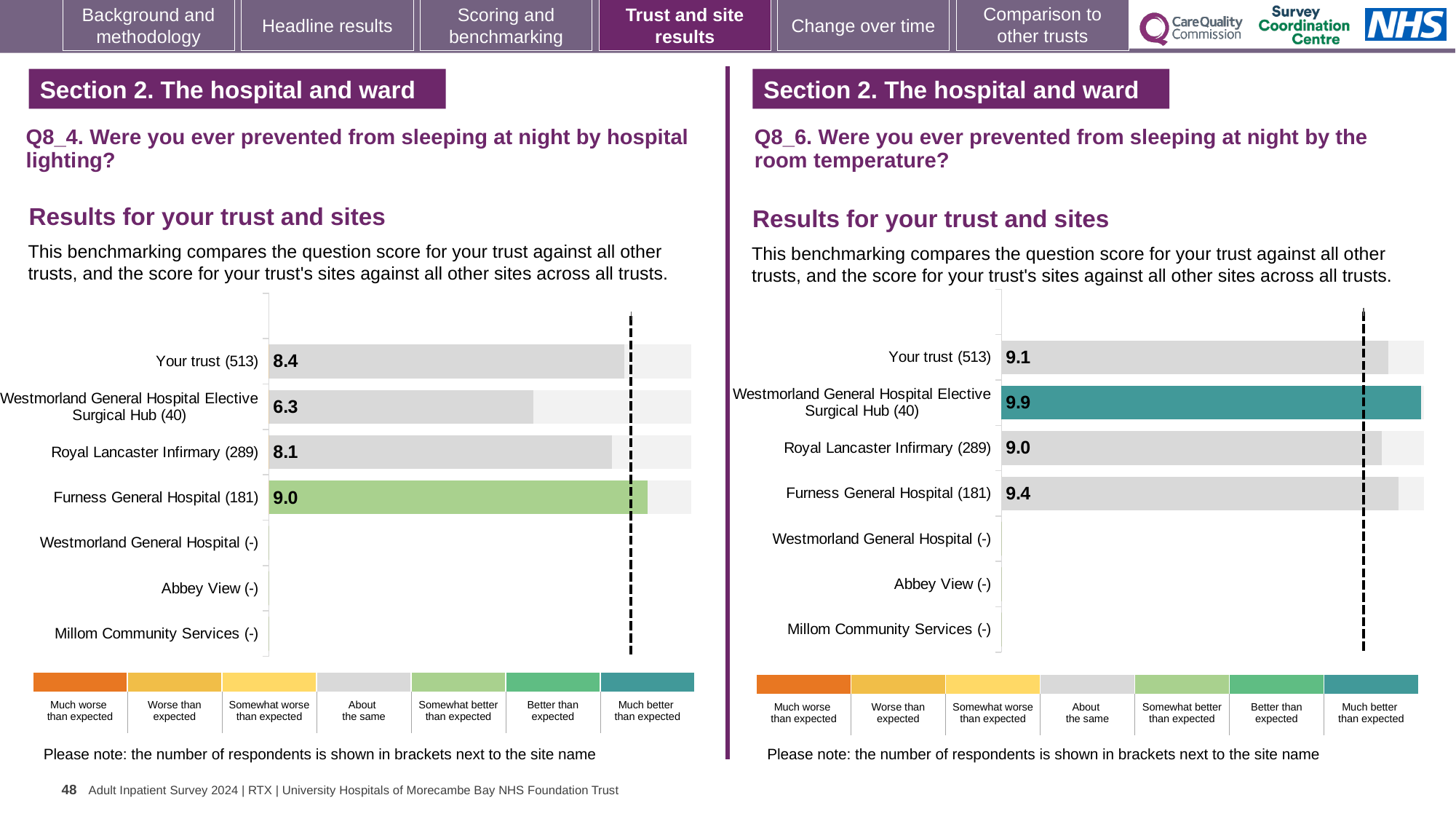
In the Q8_4 chart (hospital lighting), which site has the lowest score? Westmorland General Hospital Elective Surgical Hub (40) In the Q8_4 chart (hospital lighting), which site has the highest score? Furness General Hospital (181) What type of chart is used on the slide to show the results for the trust and sites? Bar chart In the Q8_6 chart (room temperature), which is larger: the score for Your trust (513) or for Furness General Hospital (181)? Furness General Hospital (181) In the Q8_4 chart (hospital lighting), what is the difference between the scores for Furness General Hospital (181) and Royal Lancaster Infirmary (289)? 0.9 How many sites in the Q8_4 chart (hospital lighting) have a score bar plotted? 4 In the Q8_6 chart (room temperature), what is the difference between the scores for Westmorland General Hospital Elective Surgical Hub (40) and Your trust (513)? 0.8 In the Q8_6 chart (room temperature), which site has the lowest score? Royal Lancaster Infirmary (289) In the Q8_6 chart (room temperature), what is the score for Westmorland General Hospital Elective Surgical Hub (40)? 9.9 In the Q8_6 chart (room temperature), what is the score for Furness General Hospital (181)? 9.4 In the Q8_4 chart (hospital lighting), what is the score for Your trust (513)? 8.4 In the Q8_4 chart (hospital lighting), what is the score for Westmorland General Hospital Elective Surgical Hub (40)? 6.3